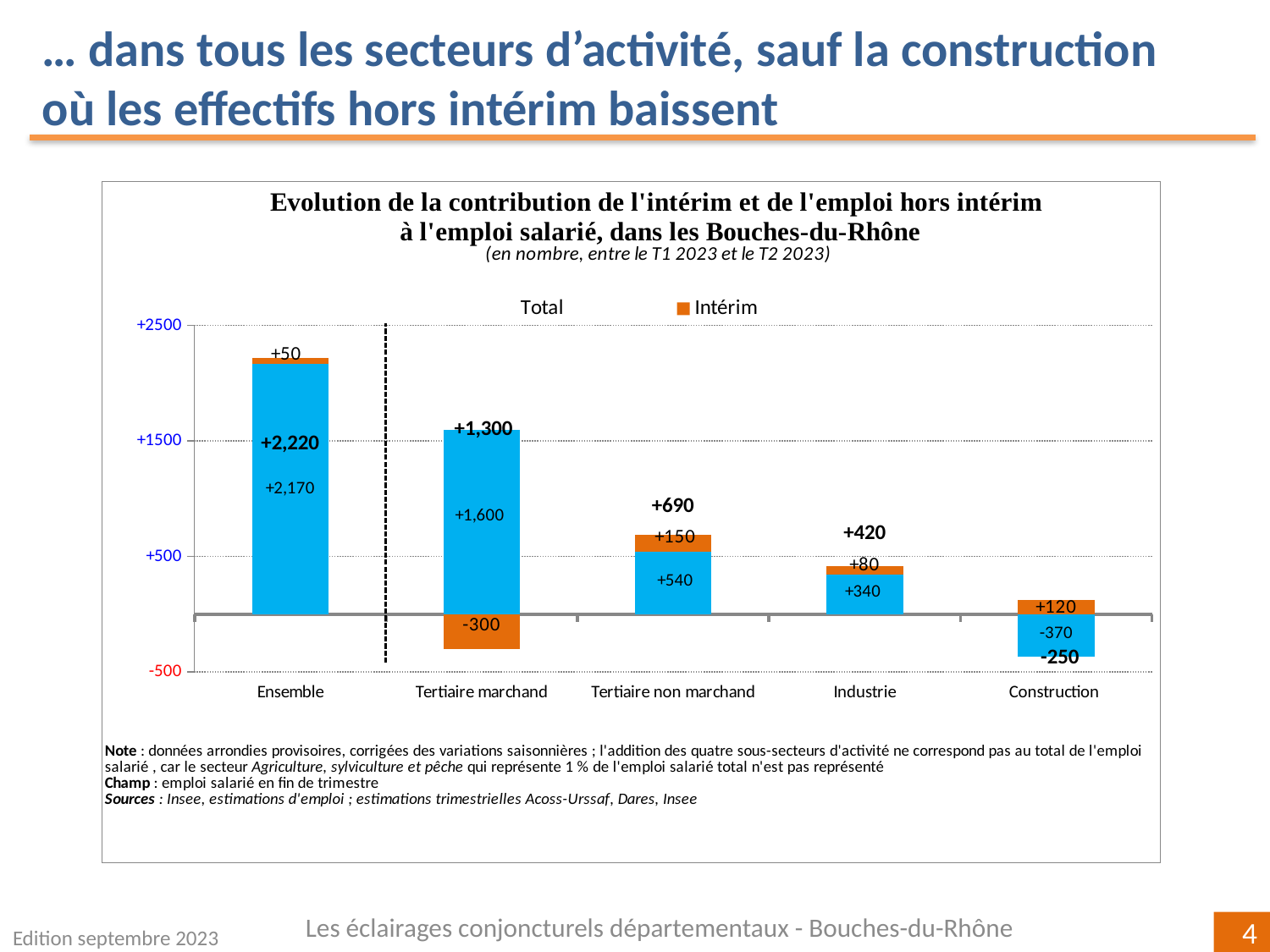
Is the Intérim value for Construction larger or smaller than the Intérim value for Industrie? larger What is the blue (hors intérim) value for Industrie? +340 What colour represents the Intérim series? orange Among the four sub-sectors (excluding Ensemble), which has the highest total value? Tertiaire marchand What is the total value shown for Ensemble? +2,220 What is the total value shown for Construction? -250 Which category has the lowest total value? Construction What is the Intérim value for Tertiaire marchand? -300 How many series does the legend list? 2 How many categories are shown on the x axis? 5 What kind of chart is this? stacked bar chart What is the difference between the total for Tertiaire non marchand and the total for Industrie? 270